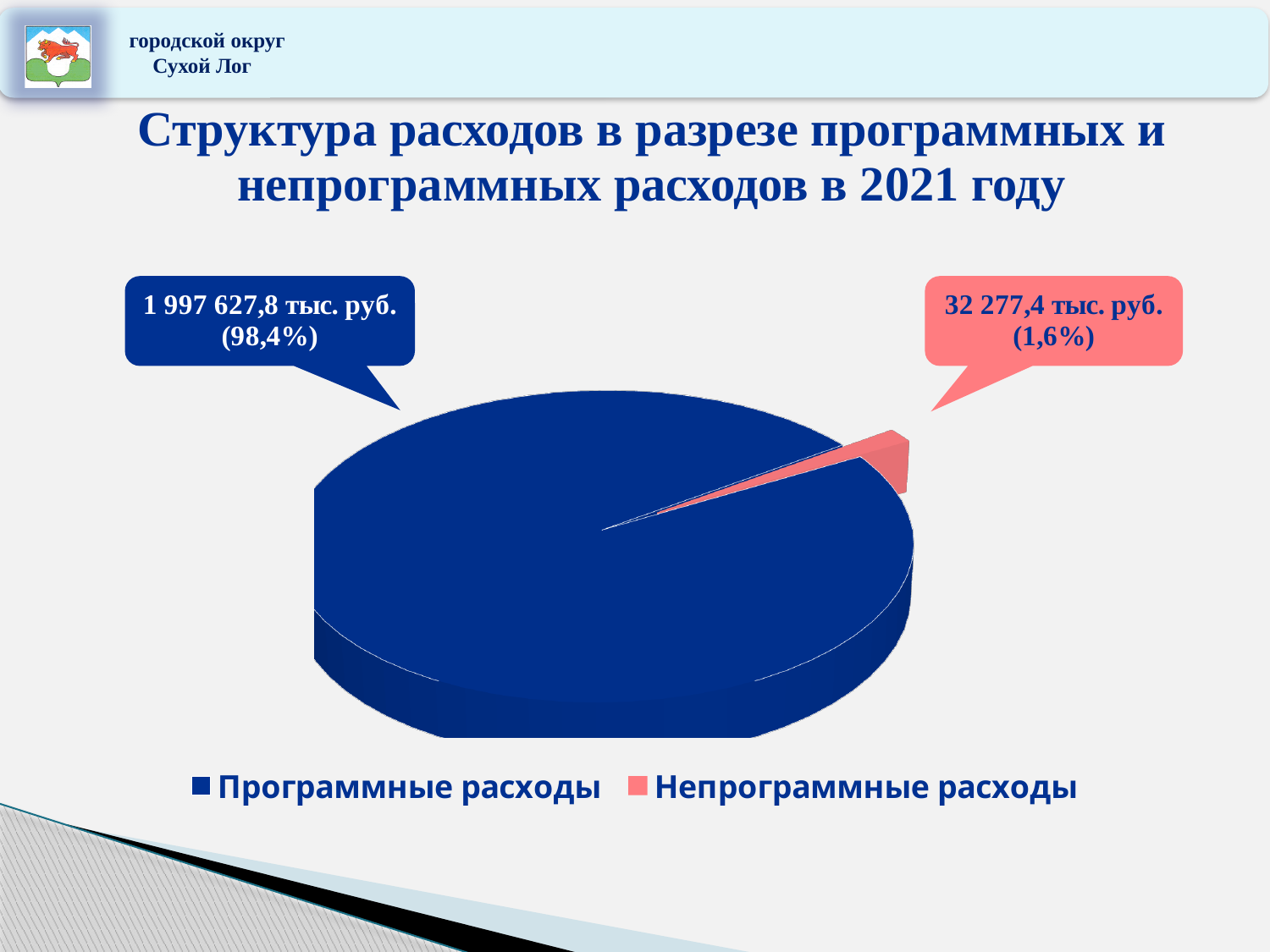
What share of the pie does Непрограммные расходы take? 1,6% How many entries does the legend list? 2 What kind of chart is shown on the slide? Pie chart What colour is the slice for Непрограммные расходы? Pink (red) How many slices does the pie chart have? 2 What is the difference between Программные расходы and Непрограммные расходы in тыс. руб.? 1 965 350,4 тыс. руб. What share of the pie does Программные расходы take? 98,4% Which category has the smallest slice of the pie? Непрограммные расходы What is the value for Программные расходы? 1 997 627,8 тыс. руб. What is the value for Непрограммные расходы? 32 277,4 тыс. руб. Which category has the largest slice of the pie? Программные расходы Which is larger, Программные расходы or Непрограммные расходы? Программные расходы